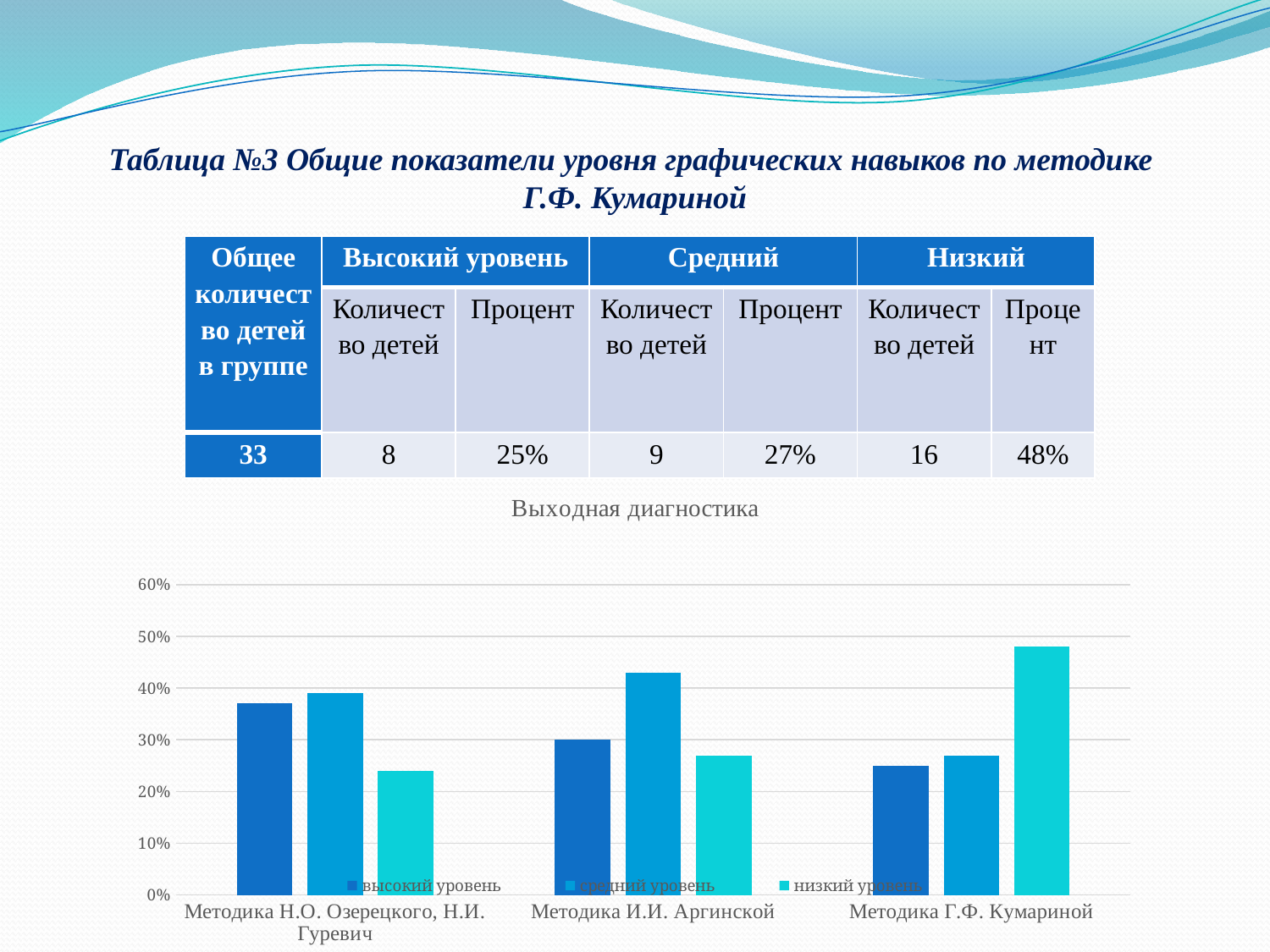
Which series has the tallest bar for Методика Г.Ф. Кумариной? низкий уровень Which is larger: низкий уровень for Методика Г.Ф. Кумариной or низкий уровень for Методика Н.О. Озерецкого, Н.И. Гуревич? Методика Г.Ф. Кумариной Is the value for высокий уровень for Методика Н.О. Озерецкого, Н.И. Гуревич greater or less than 30%? greater Which series has the shortest bar for Методика Н.О. Озерецкого, Н.И. Гуревич? низкий уровень Which is larger: высокий уровень for Методика Н.О. Озерецкого, Н.И. Гуревич or высокий уровень for Методика Г.Ф. Кумариной? Методика Н.О. Озерецкого, Н.И. Гуревич What kind of chart is shown under the table on the slide? bar chart Which series has the tallest bar for Методика И.И. Аргинской? средний уровень How many categories (methodologies) are shown on the x axis of the chart? 3 How many series does the chart legend list? 3 Is the value for низкий уровень for Методика Г.Ф. Кумариной greater or less than 50%? less Is the value for средний уровень for Методика И.И. Аргинской greater or less than 40%? greater What is the title of the chart on the slide? Выходная диагностика